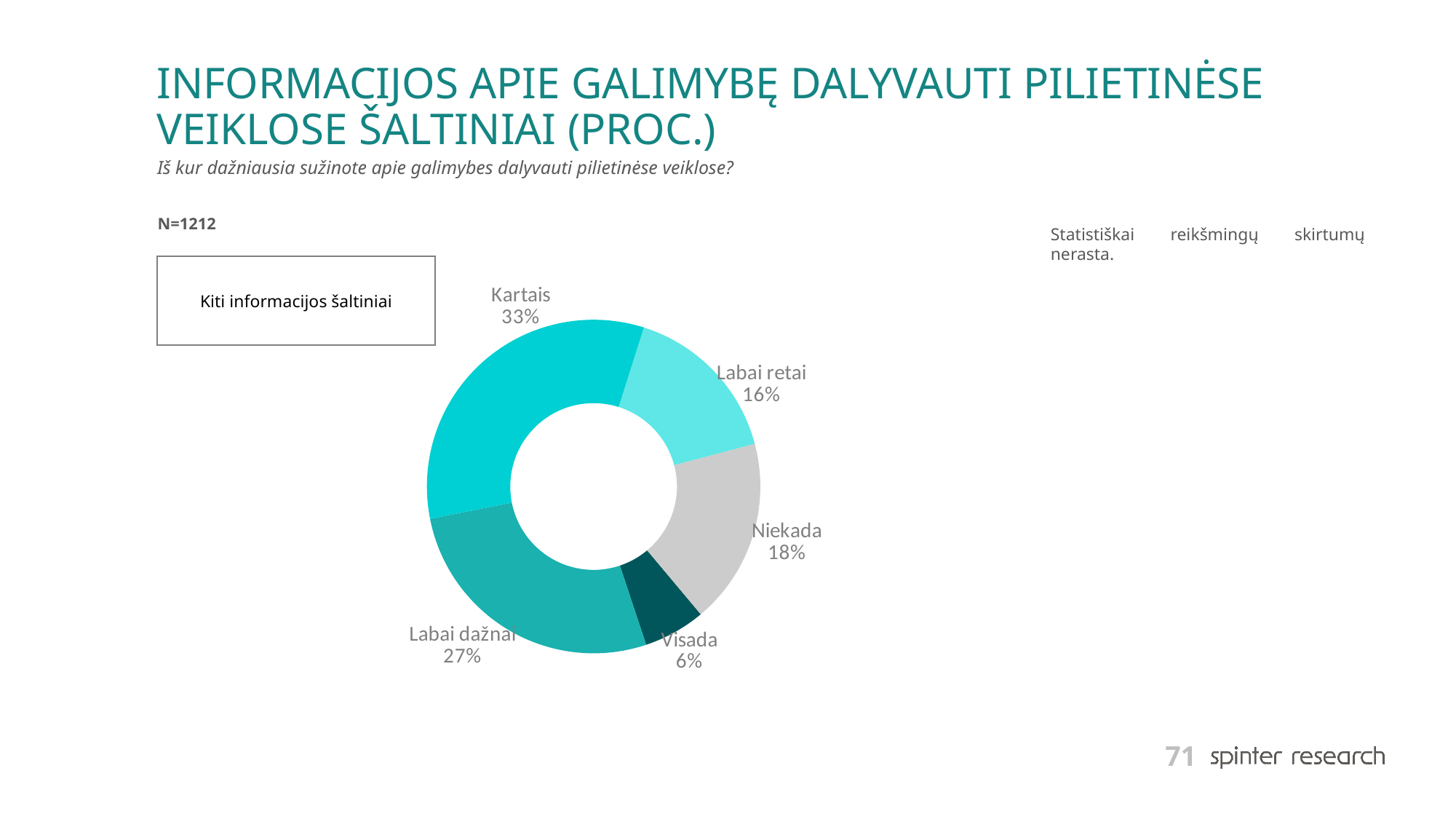
What percentage is shown for the 'Kartais' slice? 33% What percentage is shown for the 'Visada' slice? 6% What percentage is shown for the 'Labai dažnai' slice? 27% Which is larger, the share for 'Niekada' or the share for 'Labai retai'? Niekada What percentage is shown for the 'Niekada' slice? 18% How many categories are shown in the chart? 5 Which category has the smallest share of the chart? Visada Which category has the largest share of the chart? Kartais What kind of chart is shown on the slide? Doughnut (pie) chart What percentage is shown for the 'Labai retai' slice? 16% What is the difference in percentage points between 'Kartais' and 'Labai dažnai'? 6 What is the sample size (N) stated on the slide? N=1212